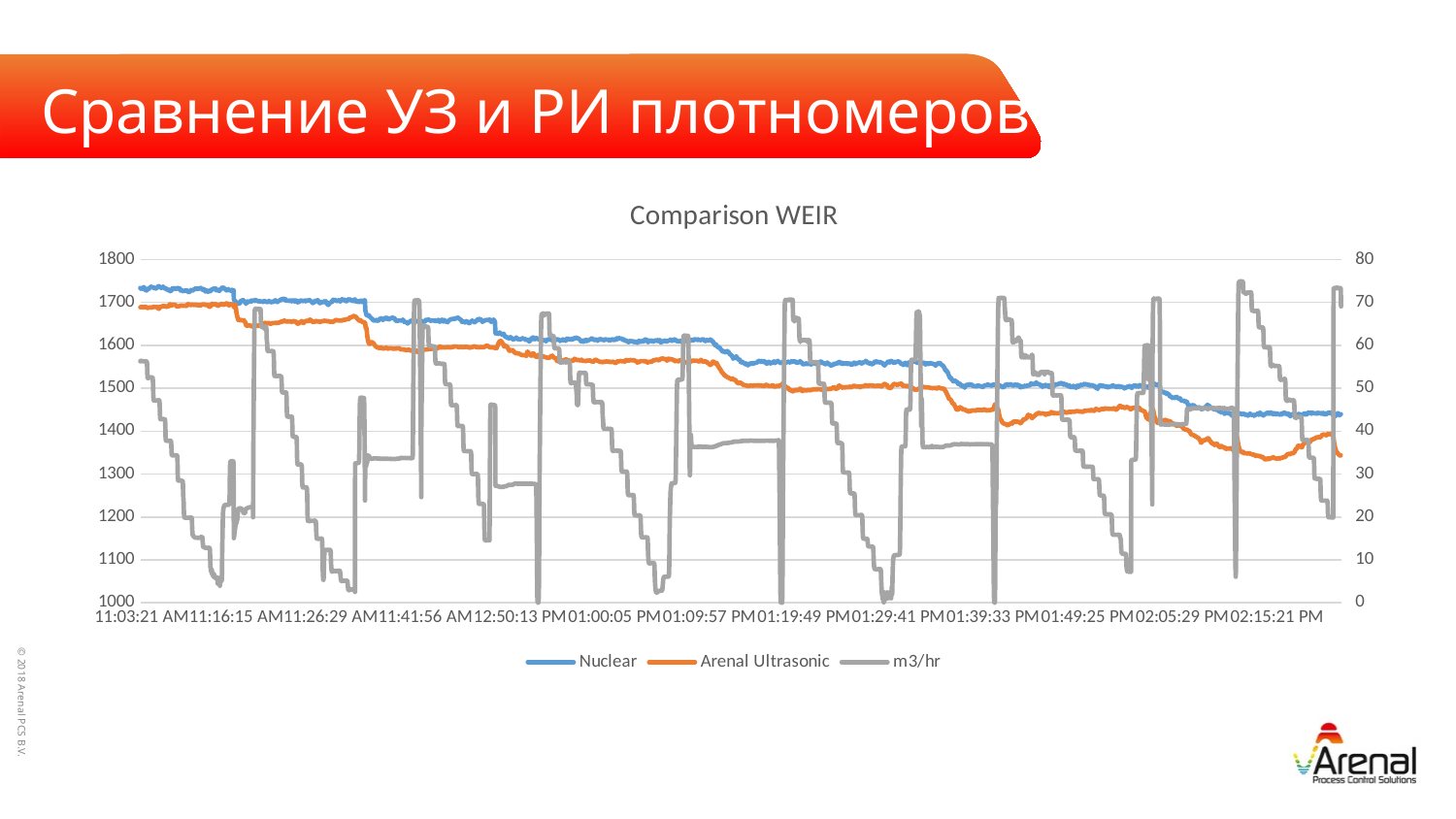
What is the title of the chart? Comparison WEIR What kind of chart is shown on the slide? line chart At the end of the chart, is the Arenal Ultrasonic value greater or less than 1400? less Which series is drawn in orange? Arenal Ultrasonic Does the Nuclear series rise or fall over the course of the x axis? fall At the start of the chart, which series is higher, Nuclear or Arenal Ultrasonic? Nuclear What is the maximum value shown on the right-hand vertical axis? 80 At the start of the chart, is the Nuclear value greater or less than 1700? greater How many series does the chart's legend list? 3 At the end of the chart, which series is higher, Nuclear or Arenal Ultrasonic? Nuclear At the end of the chart, is the Nuclear value greater or less than 1500? less Does the Arenal Ultrasonic series rise or fall from the start to the end of the x axis? fall